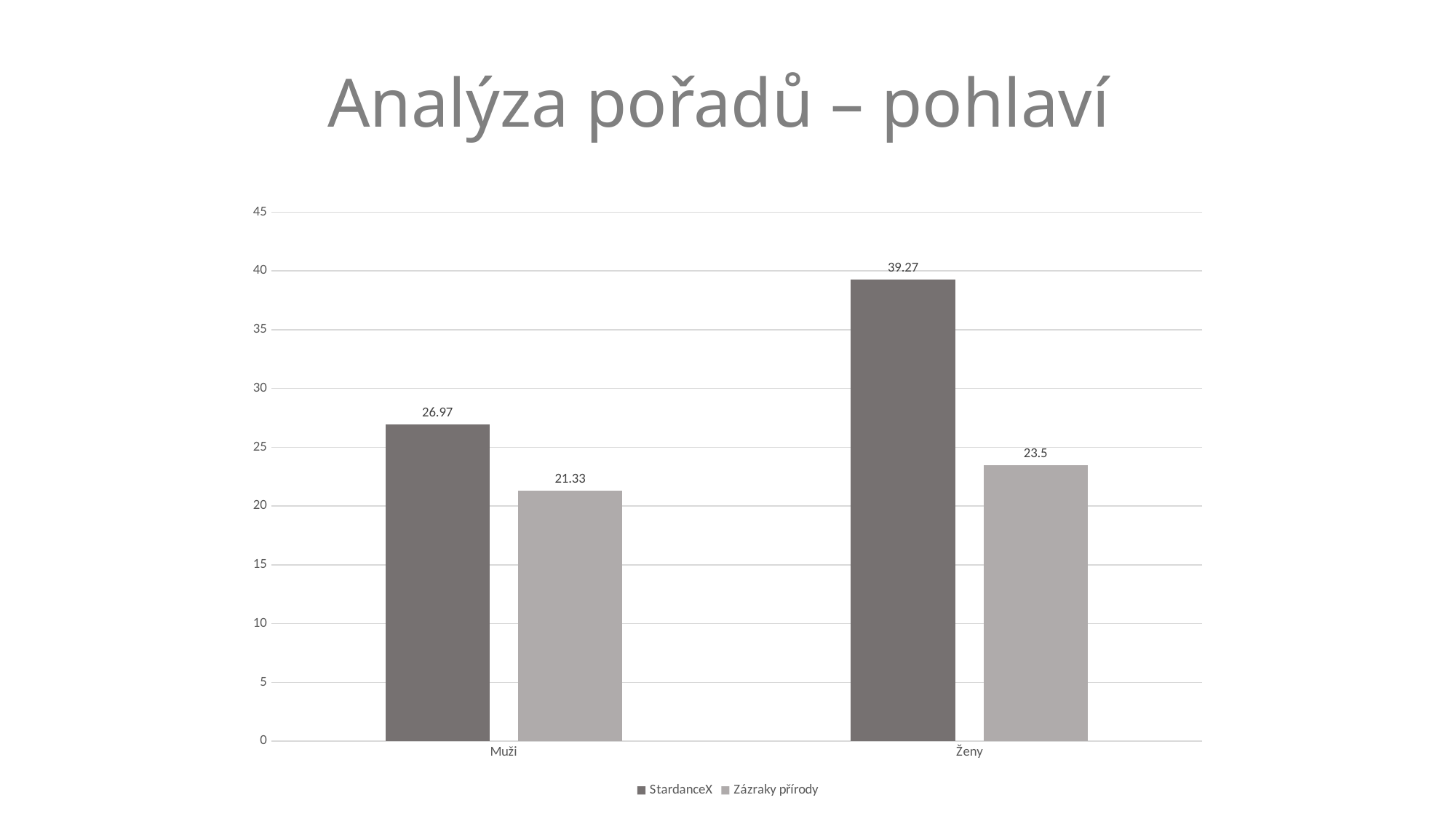
What is the difference between StardanceX and Zázraky přírody in the Ženy category? 15.77 Is the value for StardanceX in the Ženy category greater or less than 35? greater What is the value for Zázraky přírody in the Ženy category? 23.5 Which category has the highest value for StardanceX? Ženy What is the value for StardanceX in the Muži category? 26.97 Which bar has the lowest value on the chart? Zázraky přírody for Muži How many series does the legend list? 2 What is the value for Zázraky přírody in the Muži category? 21.33 What is the difference between the StardanceX values for Ženy and Muži? 12.3 How many categories are shown on the x axis? 2 What kind of chart is shown on the slide? bar chart Which is larger in the Muži category, StardanceX or Zázraky přírody? StardanceX